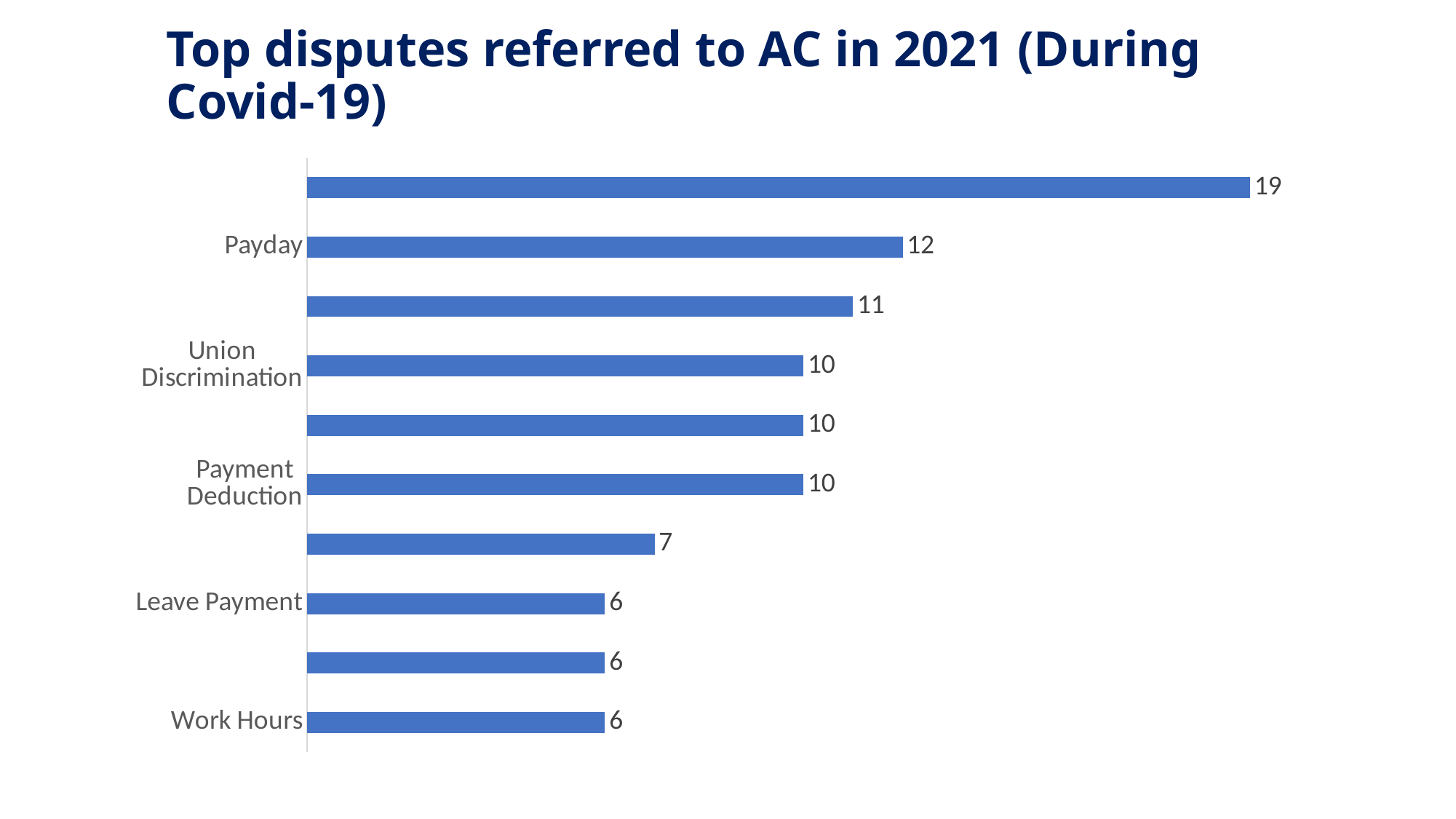
What type of chart is shown on the slide? bar chart What is the value for Union Discrimination? 10 How many bars are plotted in the chart? 10 What is the difference between the values for Payday and Union Discrimination? 2 What is the value for Payment Deduction? 10 What is the value for Payday? 12 What is the lowest value shown in the chart? 6 What is the value for Work Hours? 6 What is the title of the chart? Top disputes referred to AC in 2021 (During Covid-19) What is the highest value shown in the chart? 19 Which has a larger value, Payday or Leave Payment? Payday What is the value for Leave Payment? 6